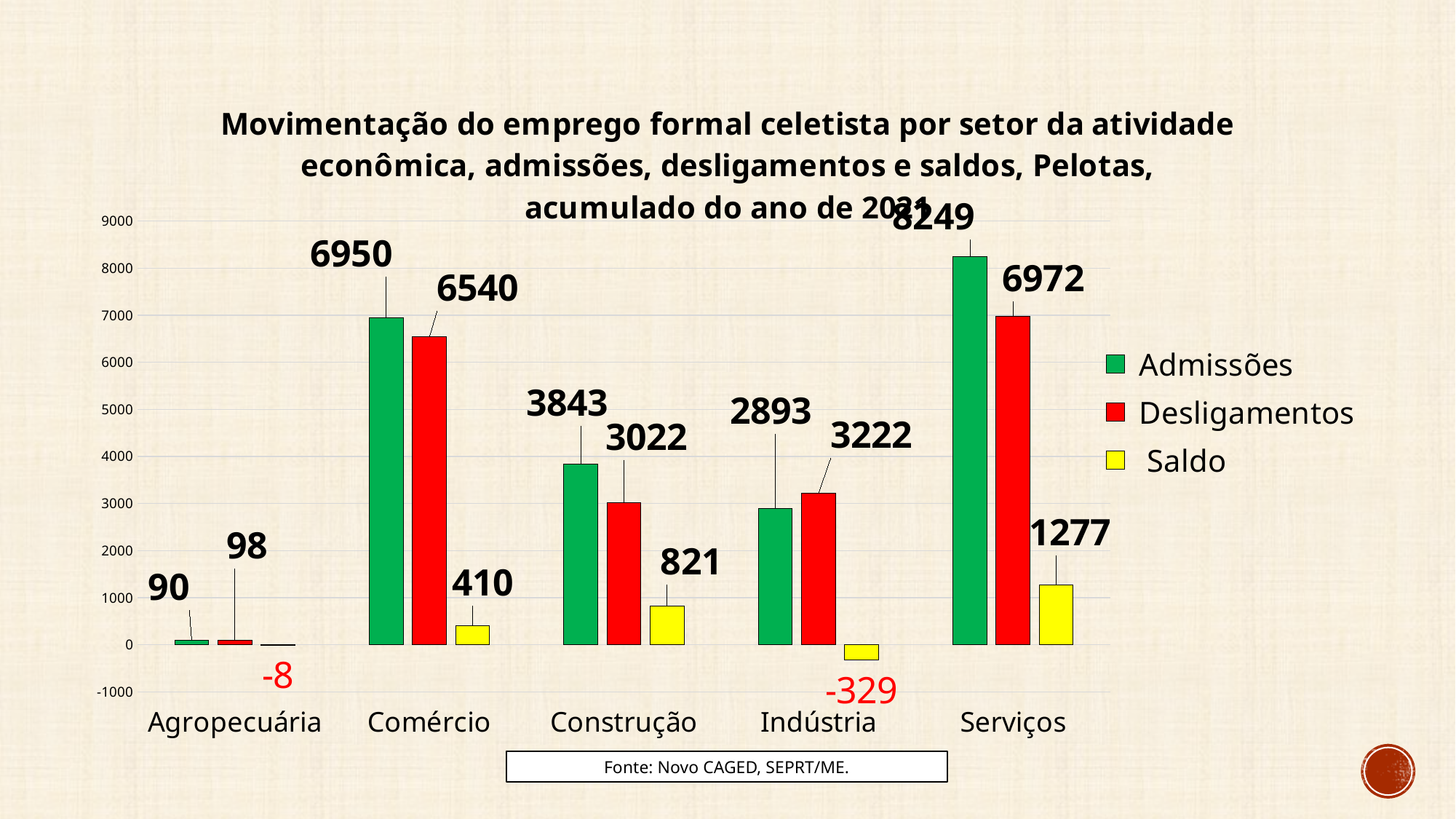
What is the value of Desligamentos for Comércio? 6540 What kind of chart is shown on the slide? bar chart How many categories are shown on the x axis? 5 What is the difference between Admissões and Desligamentos for Construção? 821 Is the Desligamentos value for Serviços greater or less than 7000? less How many series does the legend list? 3 What colour represents the Saldo series in the legend? yellow Which is larger for Indústria, Admissões or Desligamentos? Desligamentos What is the value of Admissões for Serviços? 8249 Which category has the lowest Saldo value? Indústria Which category has the highest Admissões value? Serviços What is the Saldo value for Indústria? -329